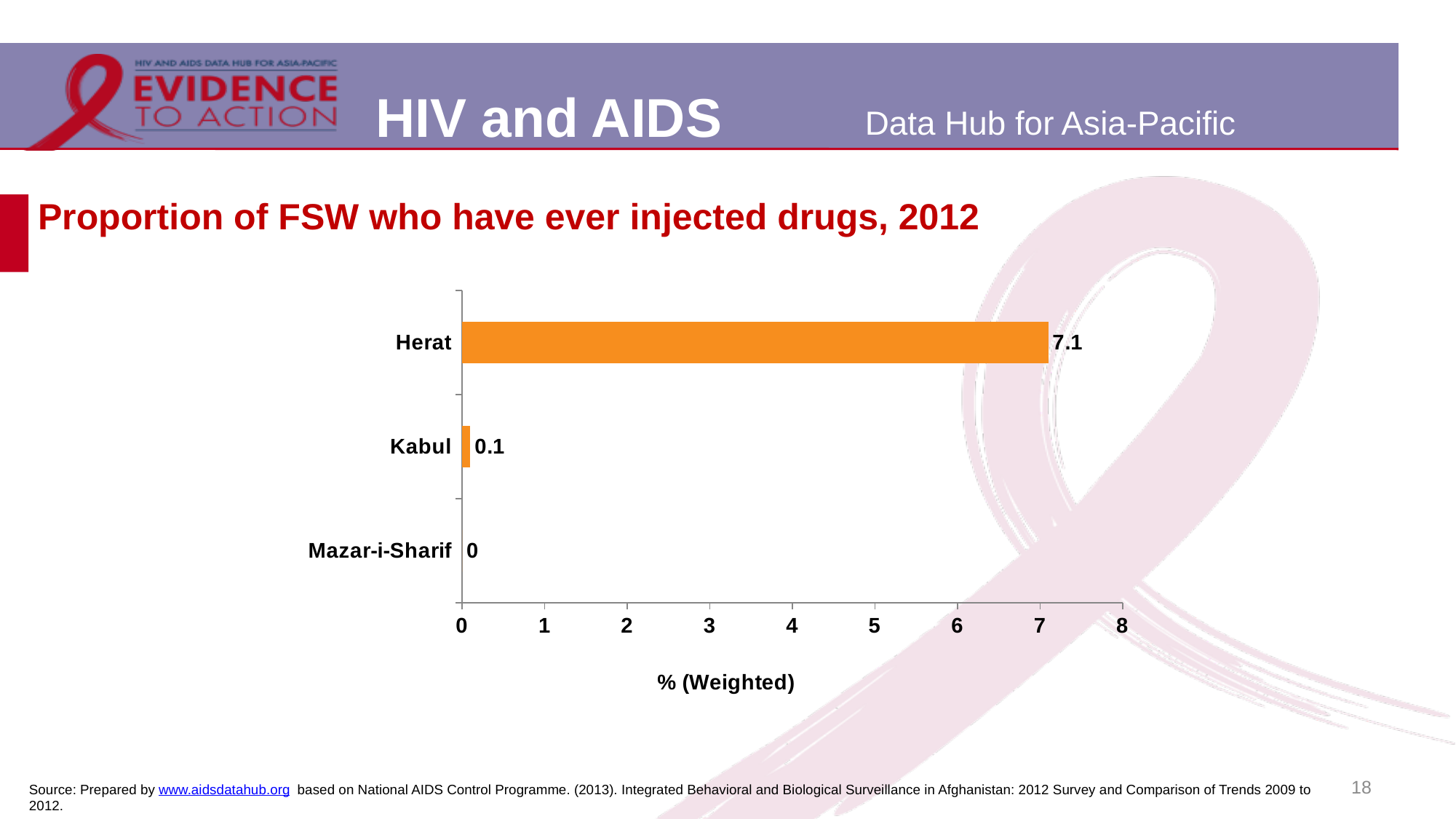
What is the title of the chart? Proportion of FSW who have ever injected drugs, 2012 Which city has the lowest proportion of FSW who have ever injected drugs? Mazar-i-Sharif What is the value for Kabul? 0.1 How many cities are shown in the chart? 3 Is the value for Herat greater or less than 5? greater What is the label of the horizontal axis? % (Weighted) What kind of chart is shown on the slide? Bar chart Which is larger, the value for Herat or the value for Kabul? Herat What is the value for Herat? 7.1 What is the difference between the values for Herat and Kabul? 7 What is the value for Mazar-i-Sharif? 0 Which city has the highest proportion of FSW who have ever injected drugs? Herat